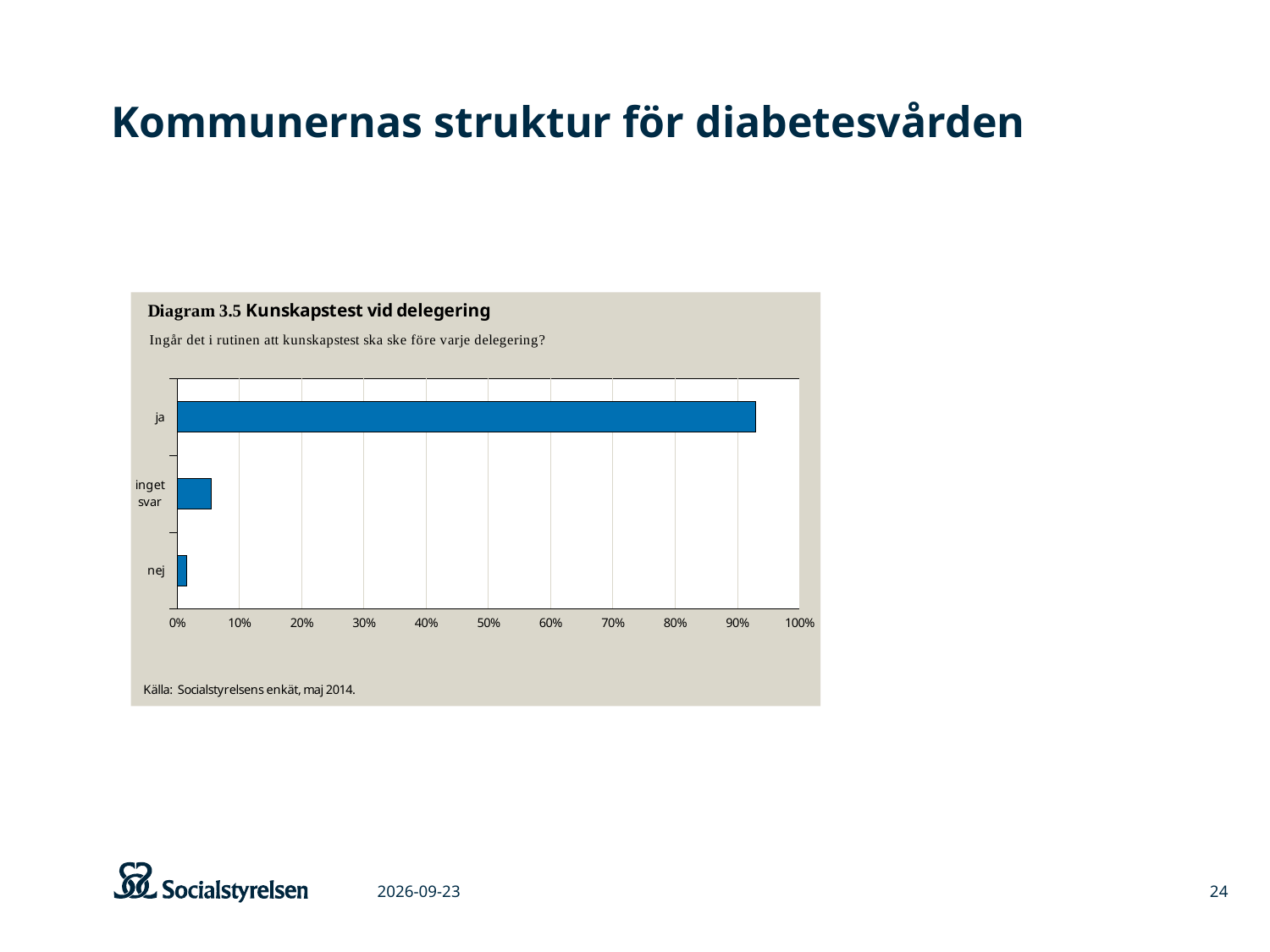
Is the value for 'nej' greater or less than 10%? less What source is cited below the chart? Socialstyrelsens enkät, maj 2014. Which category has the highest value? ja Which is larger, the value for 'inget svar' or the value for 'nej'? inget svar Is the value for 'inget svar' greater or less than 10%? less What is the title of the chart? Diagram 3.5 Kunskapstest vid delegering Is the value for 'ja' greater or less than 100%? less What kind of chart is shown on the slide? bar chart Which category has the lowest value? nej How many categories are shown in the chart? 3